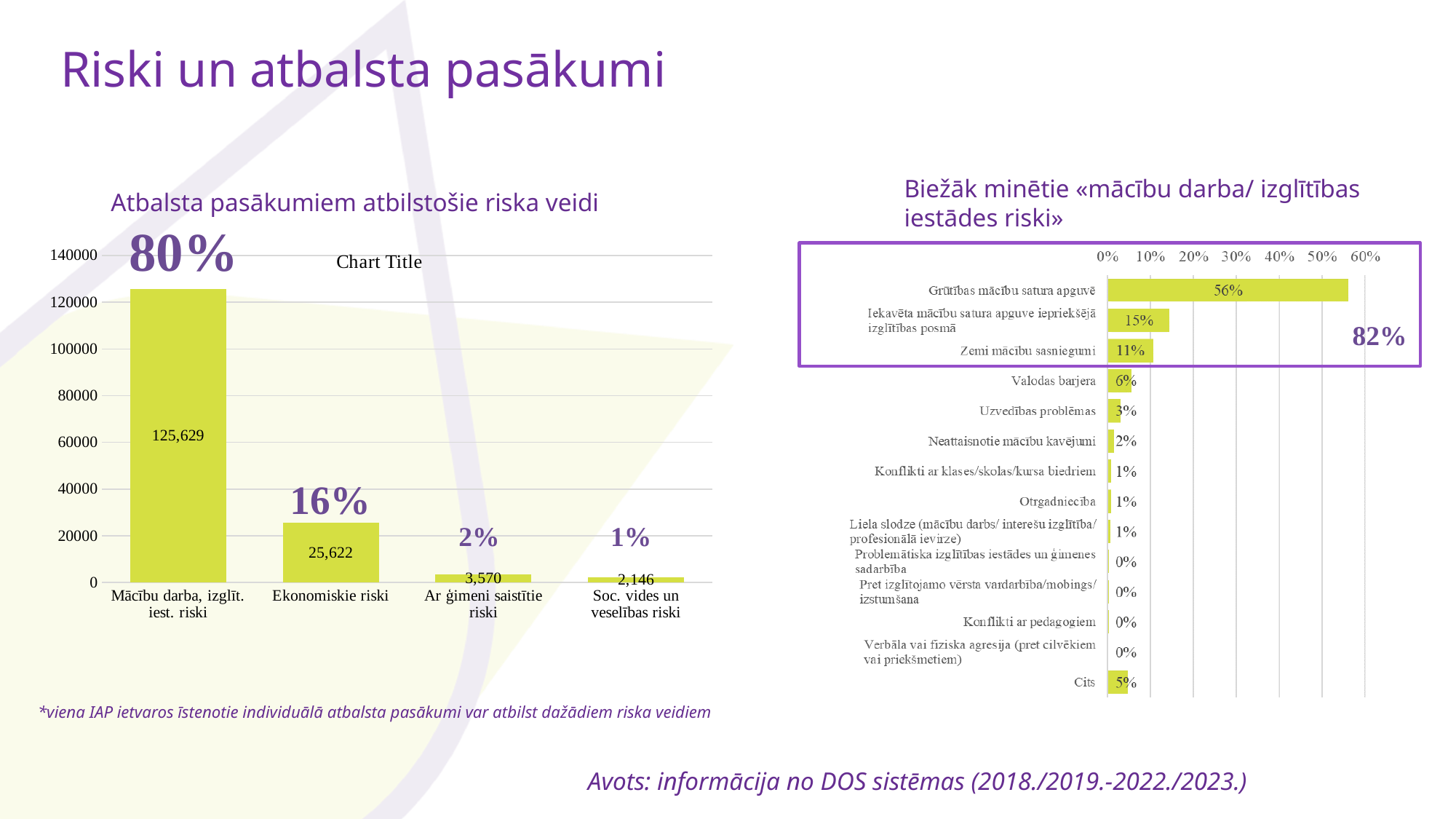
In the right chart 'Biežāk minētie «mācību darba/ izglītības iestādes riski»', what is the value for 'Grūtības mācību satura apguvē'? 56% In the left chart 'Atbalsta pasākumiem atbilstošie riska veidi', which category has the highest value? Mācību darba, izglīt. iest. riski In the right chart 'Biežāk minētie «mācību darba/ izglītības iestādes riski»', how many categories are listed? 14 In the right chart 'Biežāk minētie «mācību darba/ izglītības iestādes riski»', what is the difference between 'Iekavēta mācību satura apguve iepriekšējā izglītības posmā' and 'Zemi mācību sasniegumi'? 4% In the left chart 'Atbalsta pasākumiem atbilstošie riska veidi', what is the difference between the values for 'Ar ģimeni saistītie riski' and 'Soc. vides un veselības riski'? 1,424 In the left chart 'Atbalsta pasākumiem atbilstošie riska veidi', what percentage is shown above the 'Ekonomiskie riski' bar? 16% What kind of chart is the left chart 'Atbalsta pasākumiem atbilstošie riska veidi'? Bar chart In the right chart 'Biežāk minētie «mācību darba/ izglītības iestādes riski»', what is the value for 'Valodas barjera'? 6% In the left chart 'Atbalsta pasākumiem atbilstošie riska veidi', how many categories are shown? 4 In the left chart 'Atbalsta pasākumiem atbilstošie riska veidi', which category has the lowest value? Soc. vides un veselības riski In the left chart 'Atbalsta pasākumiem atbilstošie riska veidi', what is the value for 'Ekonomiskie riski'? 25,622 In the right chart 'Biežāk minētie «mācību darba/ izglītības iestādes riski»', which is larger: 'Zemi mācību sasniegumi' or 'Cits'? Zemi mācību sasniegumi